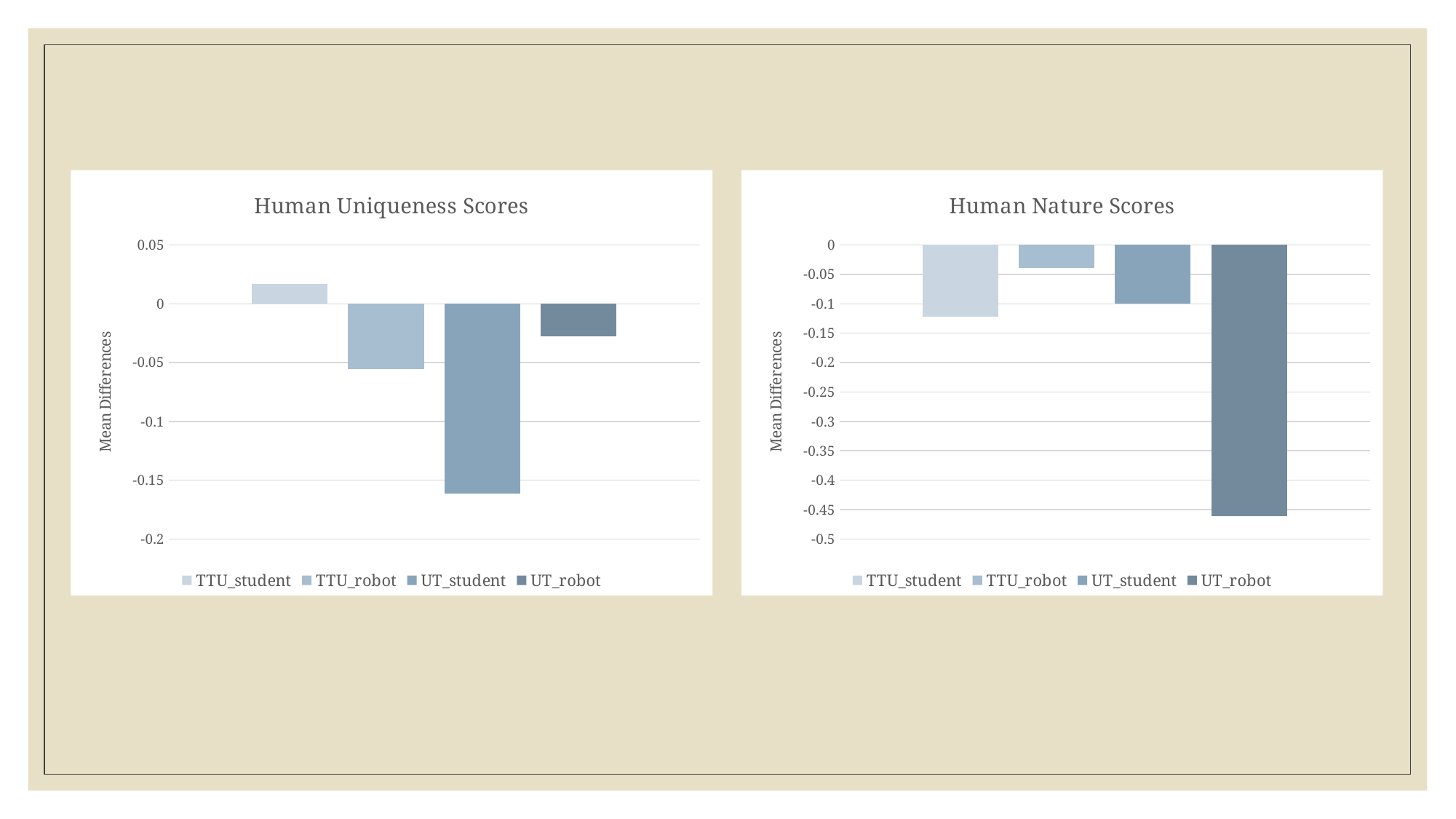
In the Human Uniqueness Scores chart, which is larger, the value for TTU_robot or the value for UT_robot? UT_robot In the Human Uniqueness Scores chart, which series has the highest value? TTU_student What kind of chart is the Human Uniqueness Scores chart? bar chart In the Human Uniqueness Scores chart, is the value for UT_student greater or less than -0.15? less In the Human Nature Scores chart, which series has the highest value? TTU_robot What is the y-axis label of the Human Nature Scores chart? Mean Differences In the Human Nature Scores chart, is the value for UT_robot greater or less than -0.4? less In the Human Nature Scores chart, is the value for TTU_student greater or less than -0.1? less In the Human Uniqueness Scores chart, which series has the lowest value? UT_student How many series does the legend of the Human Nature Scores chart list? 4 How many bars are plotted in the Human Uniqueness Scores chart? 4 In the Human Nature Scores chart, which series has the lowest value? UT_robot